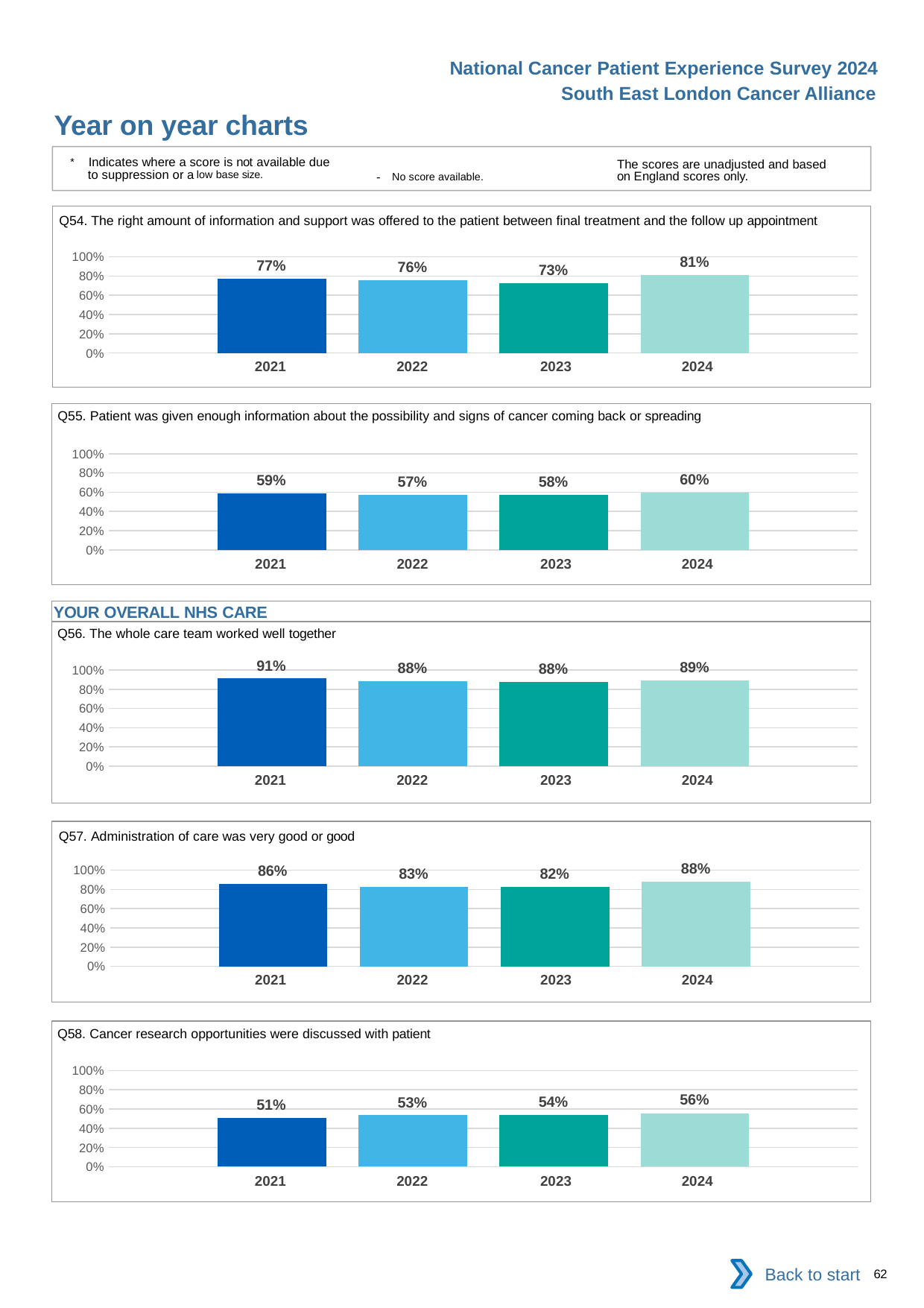
In the Q58 chart, is the value for 2021 greater or less than 60%? less In the Q56 chart, which year has the highest value? 2021 What kind of chart is the Q54 chart? Bar chart How many years are shown in the Q58 chart? 4 In the Q58 chart, do the values rise or fall from 2021 to 2024? Rise In the Q54 chart, which year has the lowest value? 2023 In the Q57 chart, is the value for 2021 larger than the value for 2023? Yes In the Q55 chart, what is the difference between the 2024 and 2022 values? 3 percentage points In the Q57 chart, what is the difference between the 2024 and 2021 values? 2 percentage points In the Q55 chart, what is the value for 2021? 59% In the Q56 chart, what is the value for 2023? 88% In the Q54 chart, what is the value for 2024? 81%